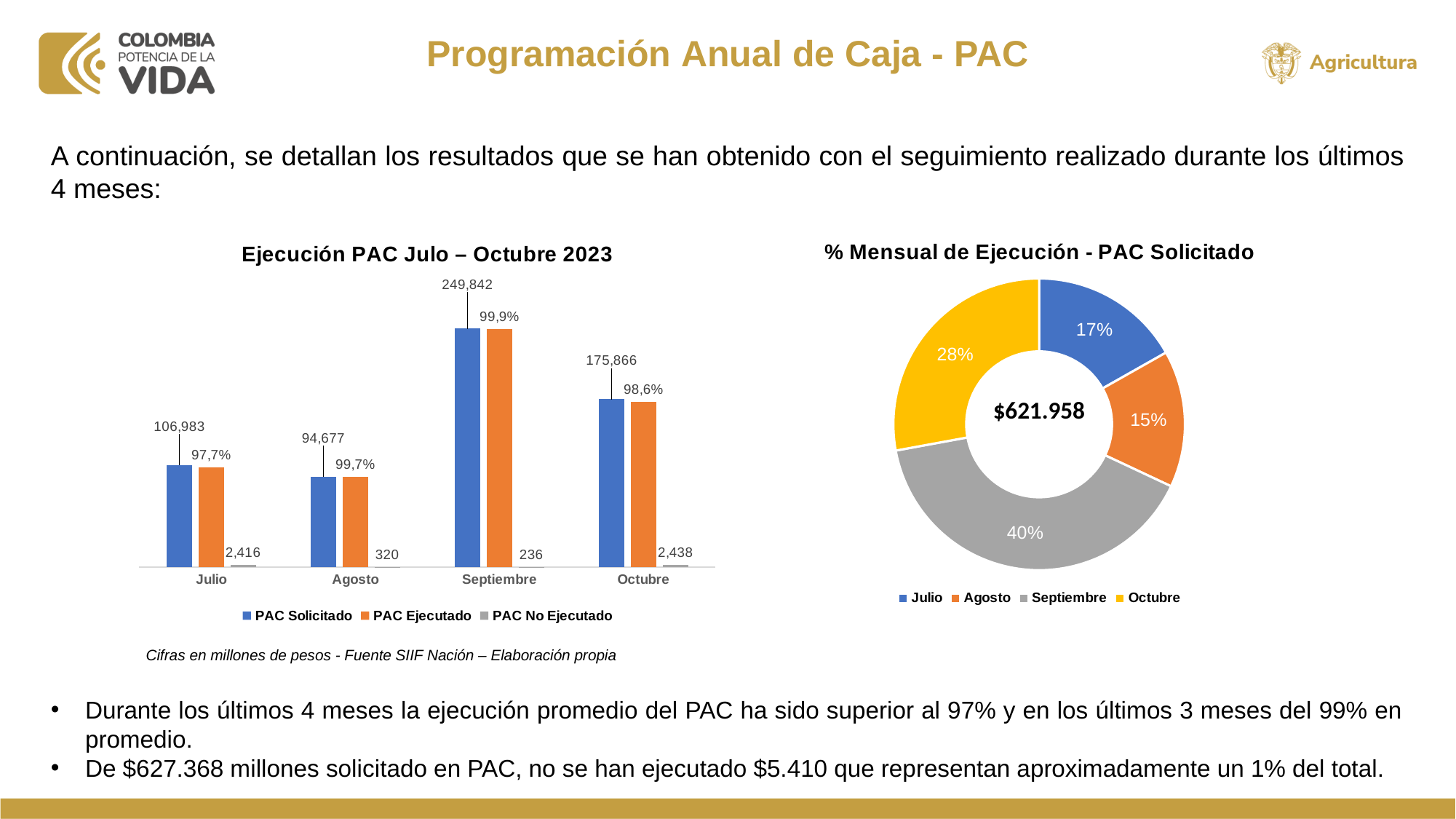
In the 'Ejecución PAC Julo – Octubre 2023' chart, which month has the highest PAC Solicitado value? Septiembre How many series does the legend of the 'Ejecución PAC Julo – Octubre 2023' chart list? 3 In the 'Ejecución PAC Julo – Octubre 2023' chart, which is larger: the PAC No Ejecutado value for Julio or for Octubre? Octubre In the 'Ejecución PAC Julo – Octubre 2023' chart, which month has the lowest PAC No Ejecutado value? Septiembre In the 'Ejecución PAC Julo – Octubre 2023' chart, what is the PAC No Ejecutado value for Agosto? 320 What value is shown in the centre of the '% Mensual de Ejecución - PAC Solicitado' chart? $621.958 In the '% Mensual de Ejecución - PAC Solicitado' chart, what share does Septiembre have? 40% In the 'Ejecución PAC Julo – Octubre 2023' chart, what label is shown on the PAC Ejecutado bar for Julio? 97,7% What kind of chart is 'Ejecución PAC Julo – Octubre 2023'? Bar chart In the 'Ejecución PAC Julo – Octubre 2023' chart, what is the difference between the PAC Solicitado values for Septiembre and Octubre? 73,976 In the 'Ejecución PAC Julo – Octubre 2023' chart, what is the PAC Solicitado value for Septiembre? 249,842 In the '% Mensual de Ejecución - PAC Solicitado' chart, which month has the smallest share? Agosto